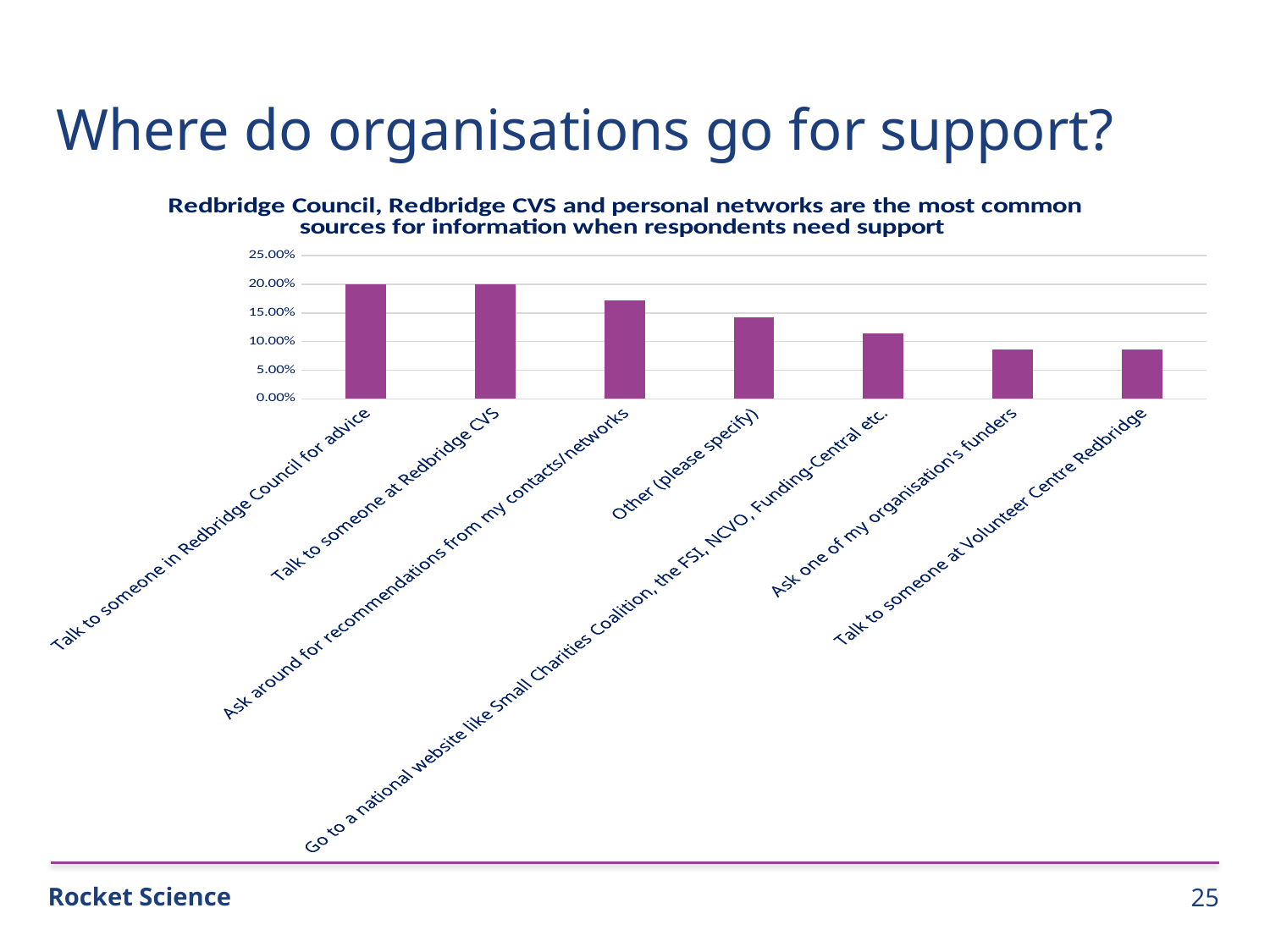
Do the bar values rise or fall moving from left to right along the x axis? fall Is the value for 'Talk to someone at Volunteer Centre Redbridge' greater or less than 10.00%? less Is the value for 'Ask around for recommendations from my contacts/networks' greater or less than 15.00%? greater How many categories (sources of support) are shown in the chart? 7 What kind of chart is shown on the slide? bar chart Is the value for 'Go to a national website like Small Charities Coalition, the FSI, NCVO, Funding-Central etc.' greater or less than 10.00%? greater Which is larger: the value for 'Talk to someone at Redbridge CVS' or the value for 'Other (please specify)'? Talk to someone at Redbridge CVS What is the value for 'Talk to someone in Redbridge Council for advice'? 20.00% What colour are the bars in the chart? purple What is the value for 'Talk to someone at Redbridge CVS'? 20.00%